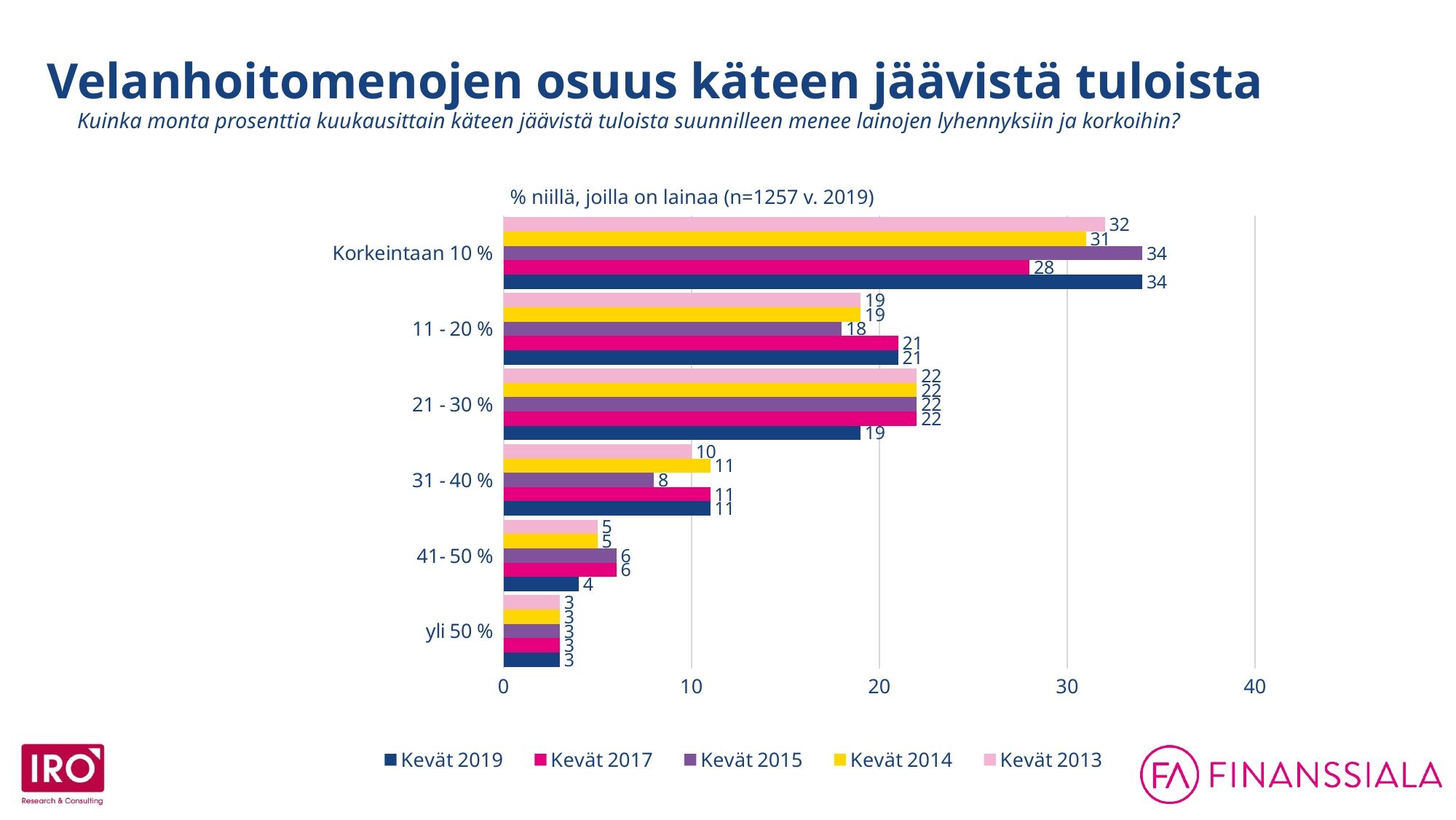
Which category has the lowest value for Kevät 2013? yli 50 % What kind of chart is shown on the slide? Bar chart What is the value for Kevät 2019 in the 41- 50 % category? 4 How many categories are shown on the chart? 6 Is the Kevät 2014 value for Korkeintaan 10 % greater or less than 30? greater How many series does the legend list? 5 Which is larger in the 21 - 30 % category: the Kevät 2019 value or the Kevät 2017 value? Kevät 2017 What is the value for Kevät 2017 in the Korkeintaan 10 % category? 28 What is the sample size stated in the chart's subtitle for 2019? n=1257 What is the value for Kevät 2015 in the 31 - 40 % category? 8 What is the difference between the Kevät 2019 and Kevät 2017 values in the Korkeintaan 10 % category? 6 Which category has the highest value for Kevät 2019? Korkeintaan 10 %